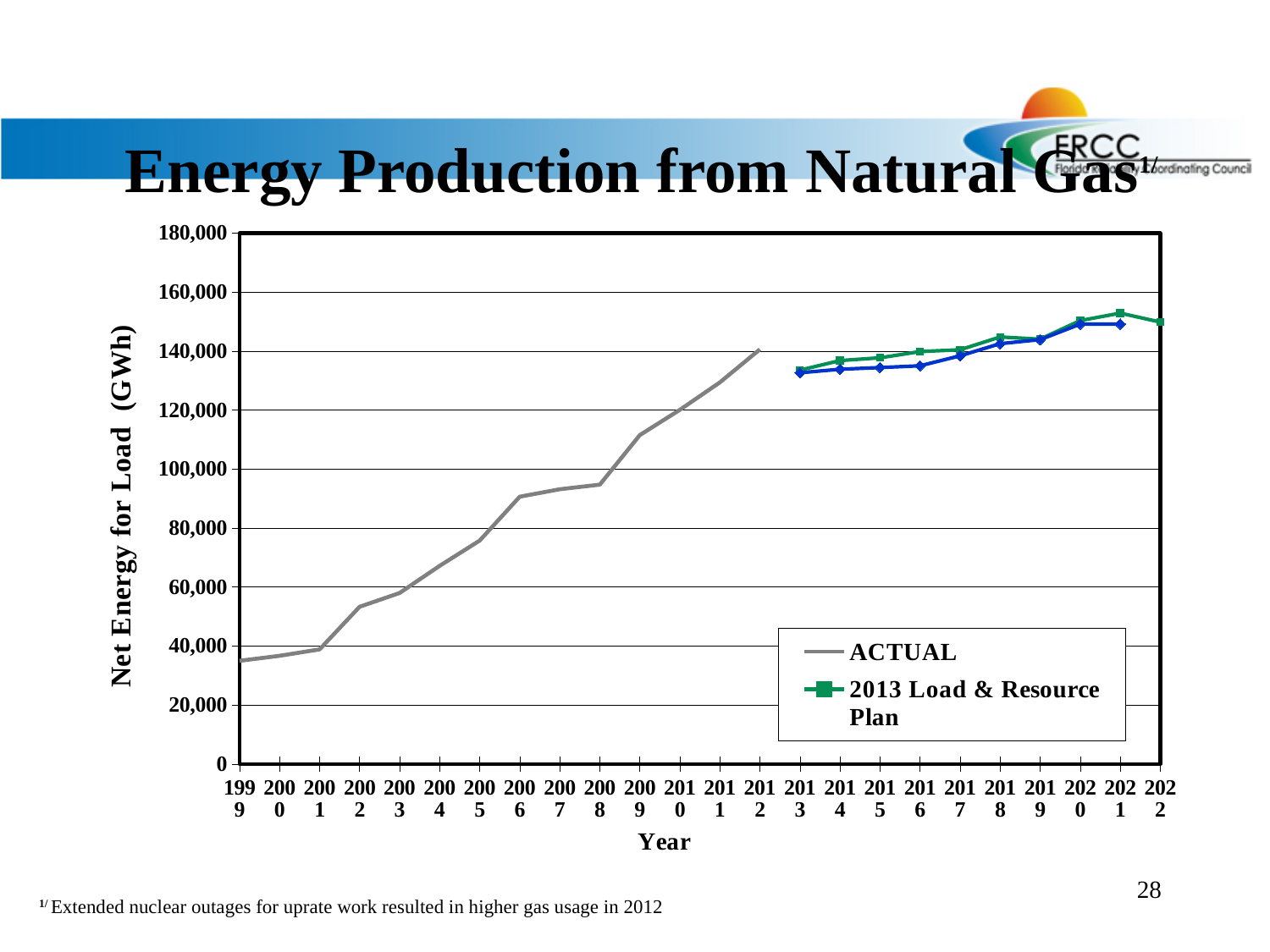
What kind of chart is shown on the slide? line chart Is the ACTUAL value for 2009 greater or less than 100,000? greater How many years are shown along the x axis of the chart? 24 What is the title of the chart on the slide? Energy Production from Natural Gas What is the label of the y axis of the chart? Net Energy for Load (GWh) Does the ACTUAL line rise or fall from 1999 to 2012? rise In which year is the ACTUAL series at its lowest? 1999 Is the 2013 Load & Resource Plan value for 2021 greater or less than 140,000? greater Which is larger, the ACTUAL value for 2006 or the ACTUAL value for 2009? 2009 How many series does the chart's legend list? 2 Is the ACTUAL value for 1999 greater or less than 40,000? less In which year is the ACTUAL series at its highest? 2012